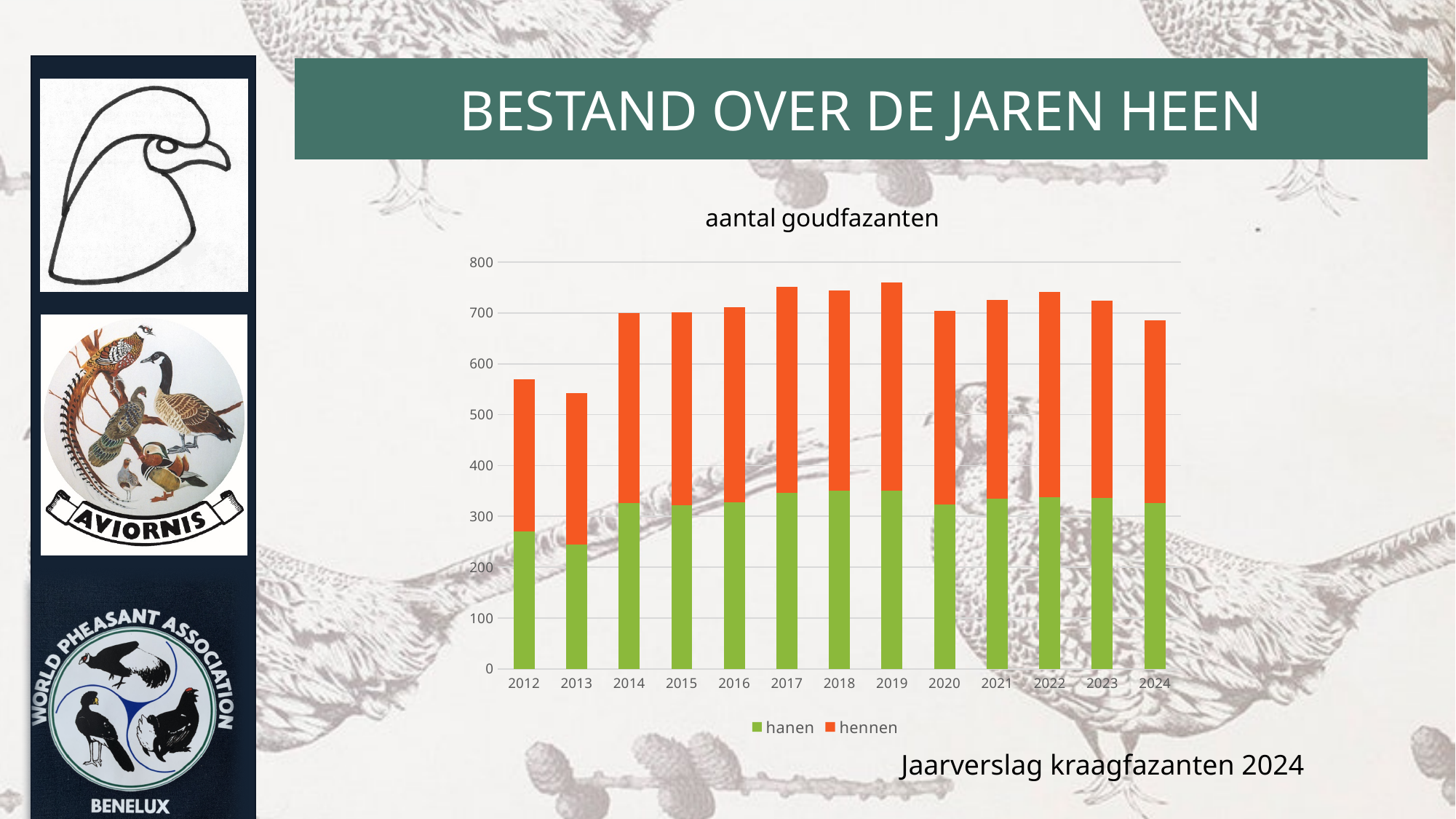
Is the total value for 2024 greater or less than 700? less Is the 'hanen' value for 2012 greater or less than 300? less Which colour represents the 'hanen' series in the chart? green How many years are shown on the x axis of the chart? 13 Which year has the lowest total number of goudfazanten? 2013 What is the title of the chart? aantal goudfazanten Which year has a larger total, 2012 or 2014? 2014 What kind of chart is shown on the slide? bar chart Is the total value for 2012 greater or less than 600? less Do the total values rise or fall from 2013 to 2014? rise How many series does the legend list? 2